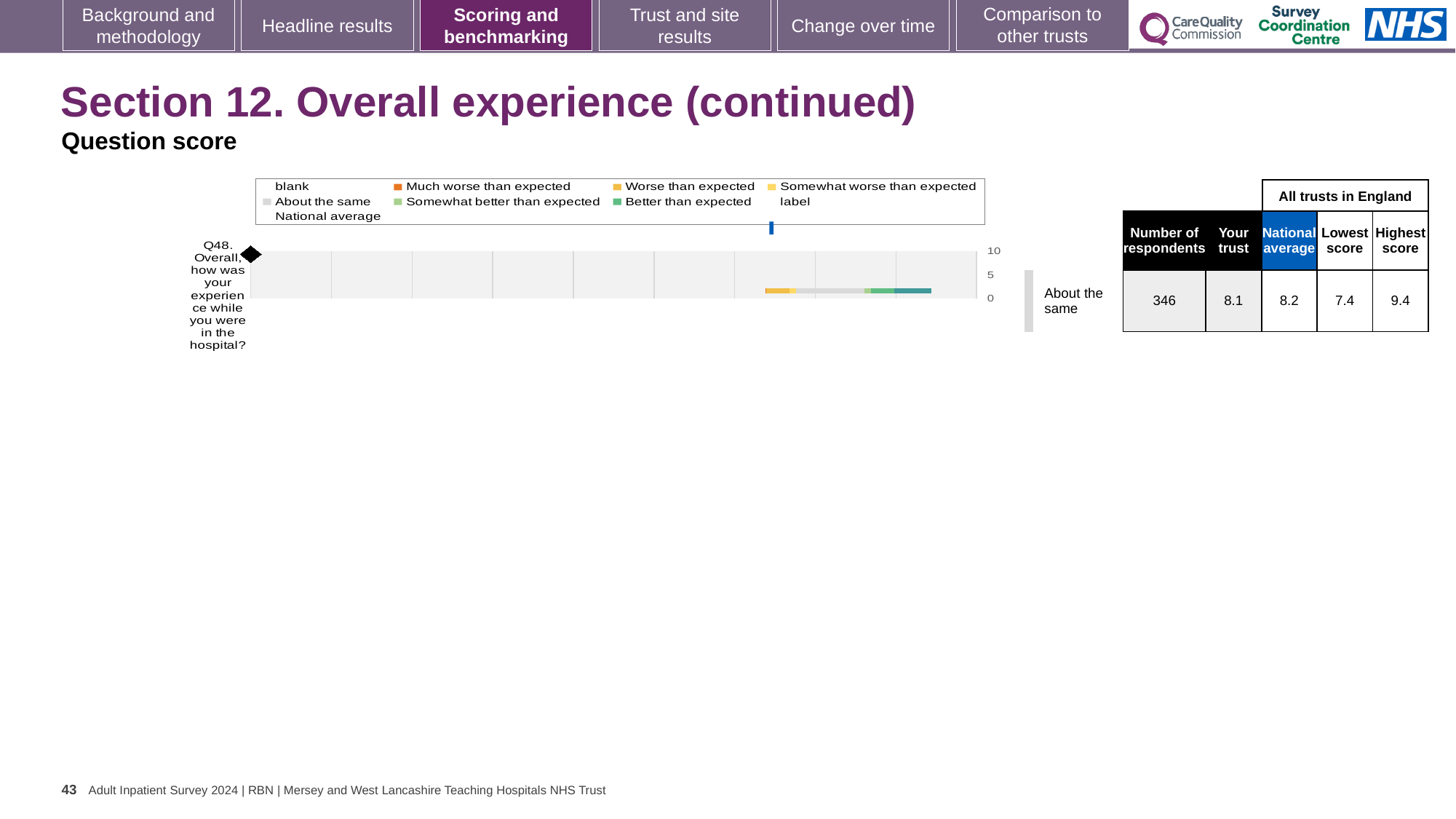
What kind of chart is shown on the slide? bar chart What is the number of respondents for Q48? 346 What is the lowest score among all trusts in England for Q48? 7.4 Which is larger for Q48, the 'Your trust' score or the national average? National average What is the national average score for Q48? 8.2 Which benchmark category is the trust's result for Q48 placed in? About the same How many questions (categories) are plotted on the chart? 1 How many entries does the chart legend list? 9 What is the highest score among all trusts in England for Q48? 9.4 What is the 'Your trust' score for Q48? 8.1 Which question is plotted on the chart? Q48. Overall, how was your experience while you were in the hospital? What is the difference between the highest score and the lowest score for Q48? 2.0